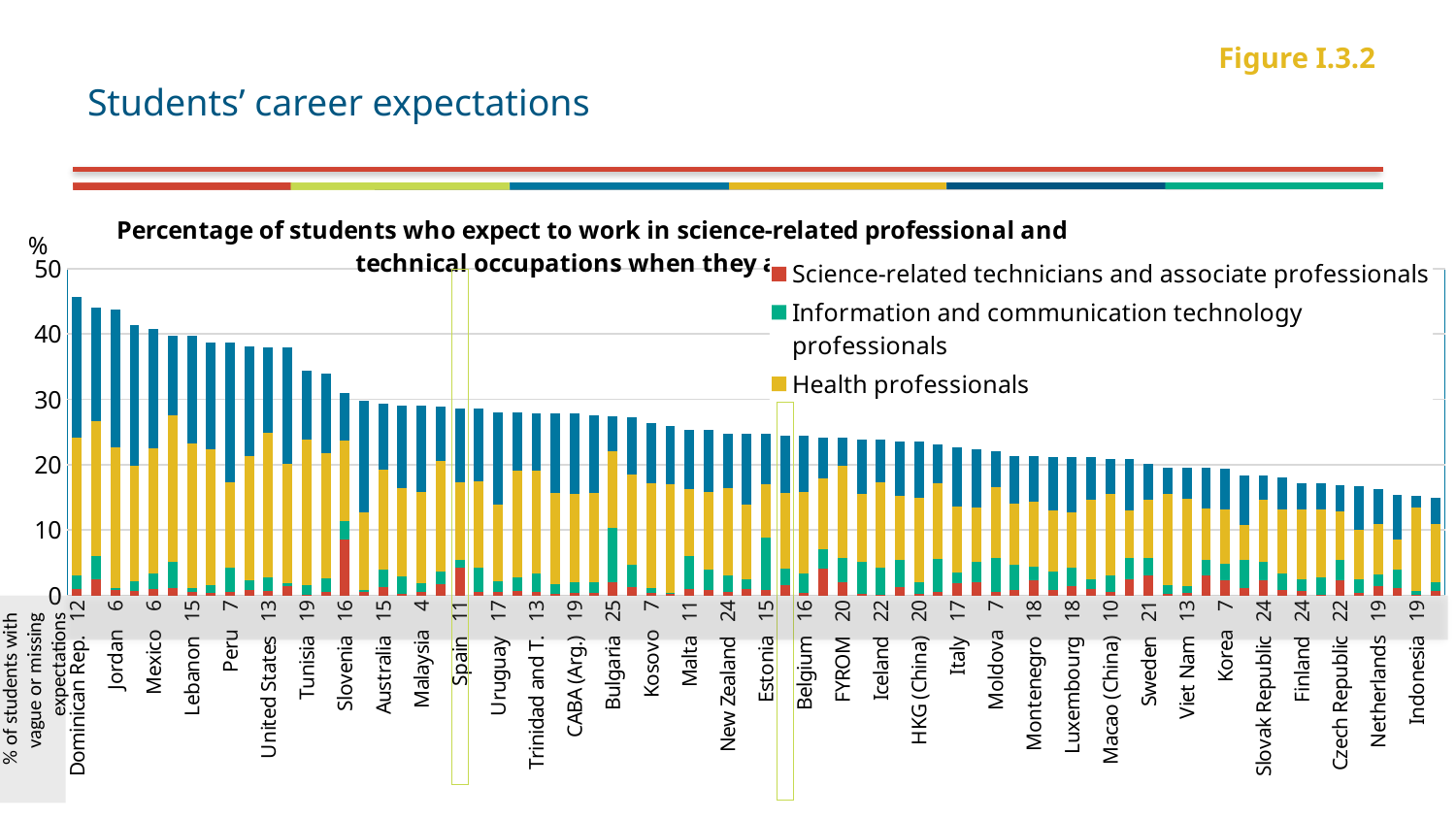
Which country has the tallest bar for the percentage of students expecting to work in science-related occupations? Dominican Rep. What is the percentage of students with vague or missing expectations shown for Malaysia? 4 How many entries does the chart legend list? 3 What is the difference between the percentage of students with vague or missing expectations for Bulgaria and for Malaysia? 21 Which has the taller total bar, Spain or Estonia? Spain What kind of chart is shown on the slide? Stacked bar chart Is the total bar for Indonesia greater or less than 20%? less Do the total bar heights rise or fall moving from left to right along the x axis? Fall Is the total bar for Dominican Rep. greater or less than 40%? greater What is the percentage of students with vague or missing expectations shown for Bulgaria? 25 What is the figure number shown in the top right corner of the slide? Figure I.3.2